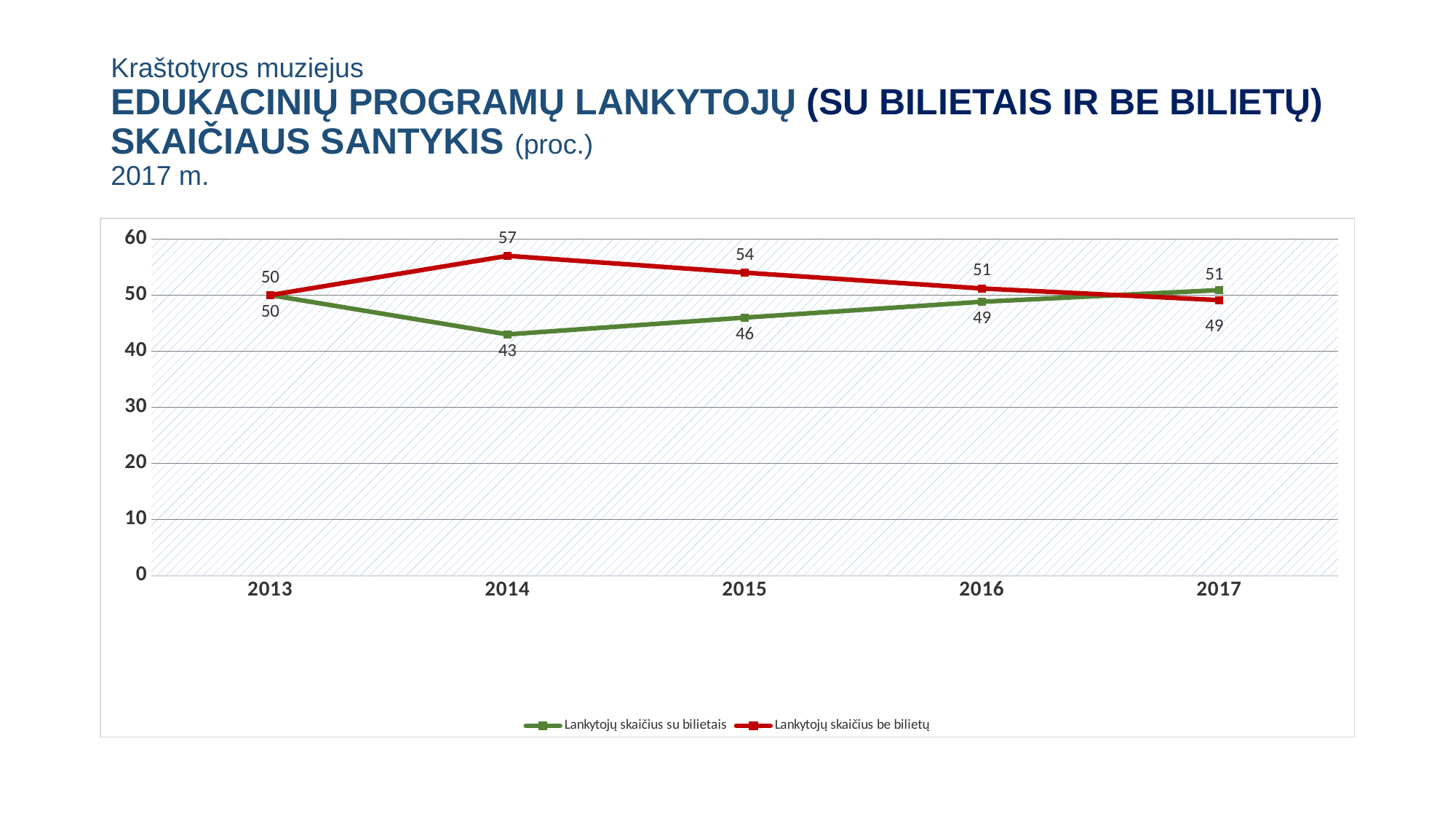
What is the value for 'Lankytojų skaičius su bilietais' in 2014? 43 What is the value for 'Lankytojų skaičius su bilietais' in 2017? 51 Which series has the larger value in 2017, 'Lankytojų skaičius su bilietais' or 'Lankytojų skaičius be bilietų'? Lankytojų skaičius su bilietais Does 'Lankytojų skaičius su bilietais' rise or fall from 2014 to 2017? rise In which year is 'Lankytojų skaičius be bilietų' highest? 2014 What is the value for 'Lankytojų skaičius be bilietų' in 2015? 54 How many years are plotted on the x axis? 5 What is the difference between 'Lankytojų skaičius be bilietų' and 'Lankytojų skaičius su bilietais' in 2014? 14 In which year is 'Lankytojų skaičius su bilietais' lowest? 2014 What kind of chart is shown on the slide? line chart How many series does the legend list? 2 Which colour is used for the 'Lankytojų skaičius be bilietų' line? red